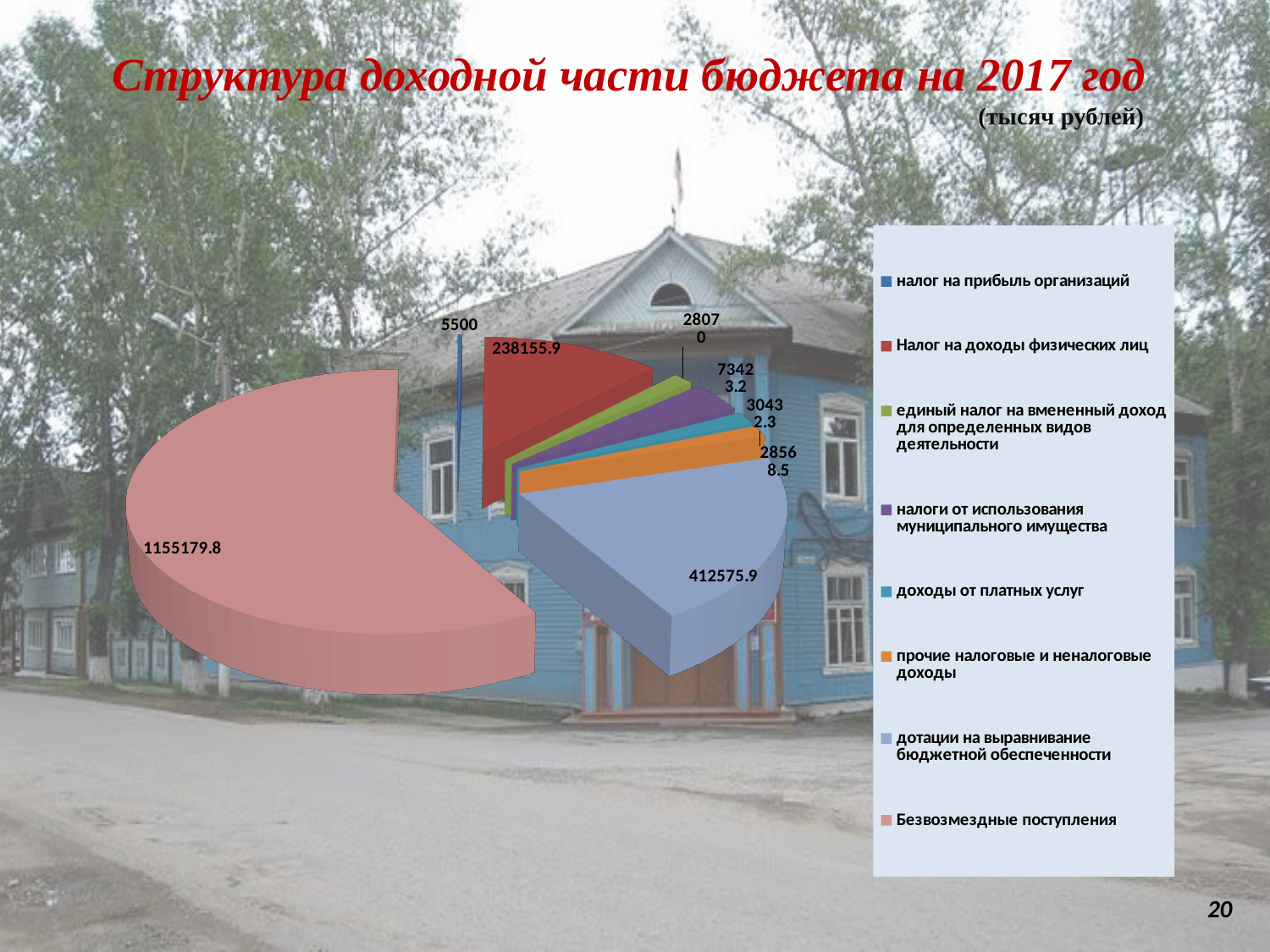
What kind of chart is shown on the slide? pie chart What is the difference between Безвозмездные поступления (1155179.8) and дотации на выравнивание бюджетной обеспеченности (412575.9)? 742603.9 What is the difference between дотации на выравнивание бюджетной обеспеченности (412575.9) and Налог на доходы физических лиц (238155.9)? 174420 How many categories does the legend list? 8 Which category has the smallest slice of the pie? налог на прибыль организаций What is the value for налог на прибыль организаций? 5500 In what units are the values on the chart given, according to the subtitle? тысяч рублей What is the value for Налог на доходы физических лиц? 238155.9 Which is larger: Безвозмездные поступления or дотации на выравнивание бюджетной обеспеченности? Безвозмездные поступления What is the value for дотации на выравнивание бюджетной обеспеченности? 412575.9 What is the value for Безвозмездные поступления? 1155179.8 Which category has the largest slice of the pie? Безвозмездные поступления